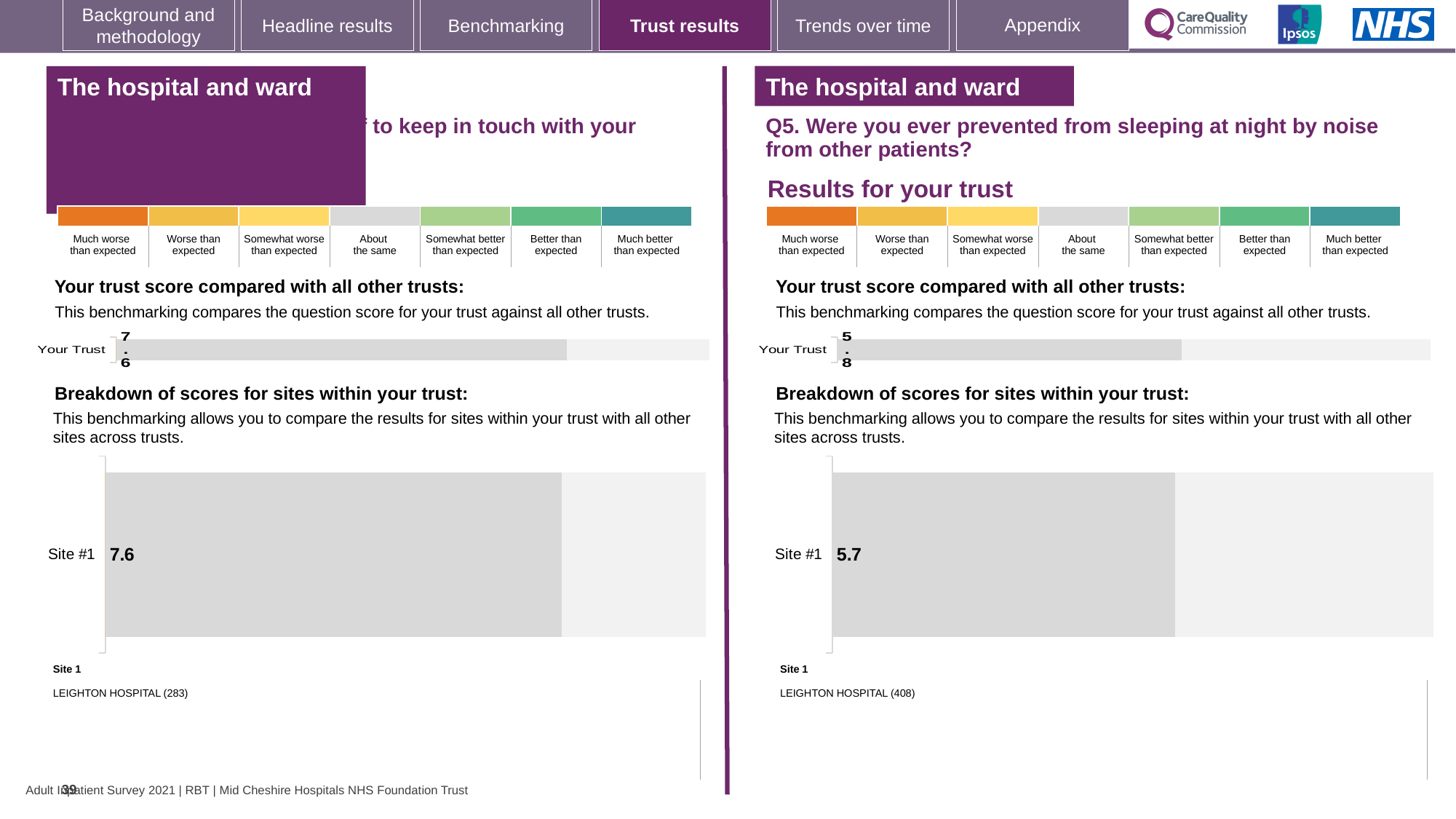
On the right-hand side of the slide (Q5, prevented from sleeping at night by noise), what is the score shown for Your Trust? 5.8 How many sites are shown in the breakdown of scores chart on the right-hand side of the slide (Q5)? 1 On the left-hand side of the slide, which hospital is listed as Site 1 below the breakdown chart? LEIGHTON HOSPITAL (283) Which is larger: the Your Trust score on the left-hand side of the slide or the Your Trust score on the right-hand side (Q5)? Left-hand side (7.6) What is the difference between the Site #1 score on the left-hand side of the slide and the Site #1 score on the right-hand side (Q5)? 1.9 On the right-hand side of the slide (Q5), which hospital is listed as Site 1 below the breakdown chart? LEIGHTON HOSPITAL (408) Is the Site #1 score on the left-hand side of the slide greater or less than the Site #1 score on the right-hand side (Q5)? greater On the right-hand side of the slide (Q5), what is the score shown for Site #1 in the breakdown of scores for sites within your trust? 5.7 What kind of chart is used to show the Site #1 score on the right-hand side of the slide (Q5)? Bar chart On the right-hand side of the slide (Q5), what is the difference between the Your Trust score and the Site #1 score? 0.1 On the left-hand side of the slide, what is the score shown for Site #1 in the breakdown of scores for sites within your trust? 7.6 On the left-hand side of the slide, what is the score shown for Your Trust? 7.6